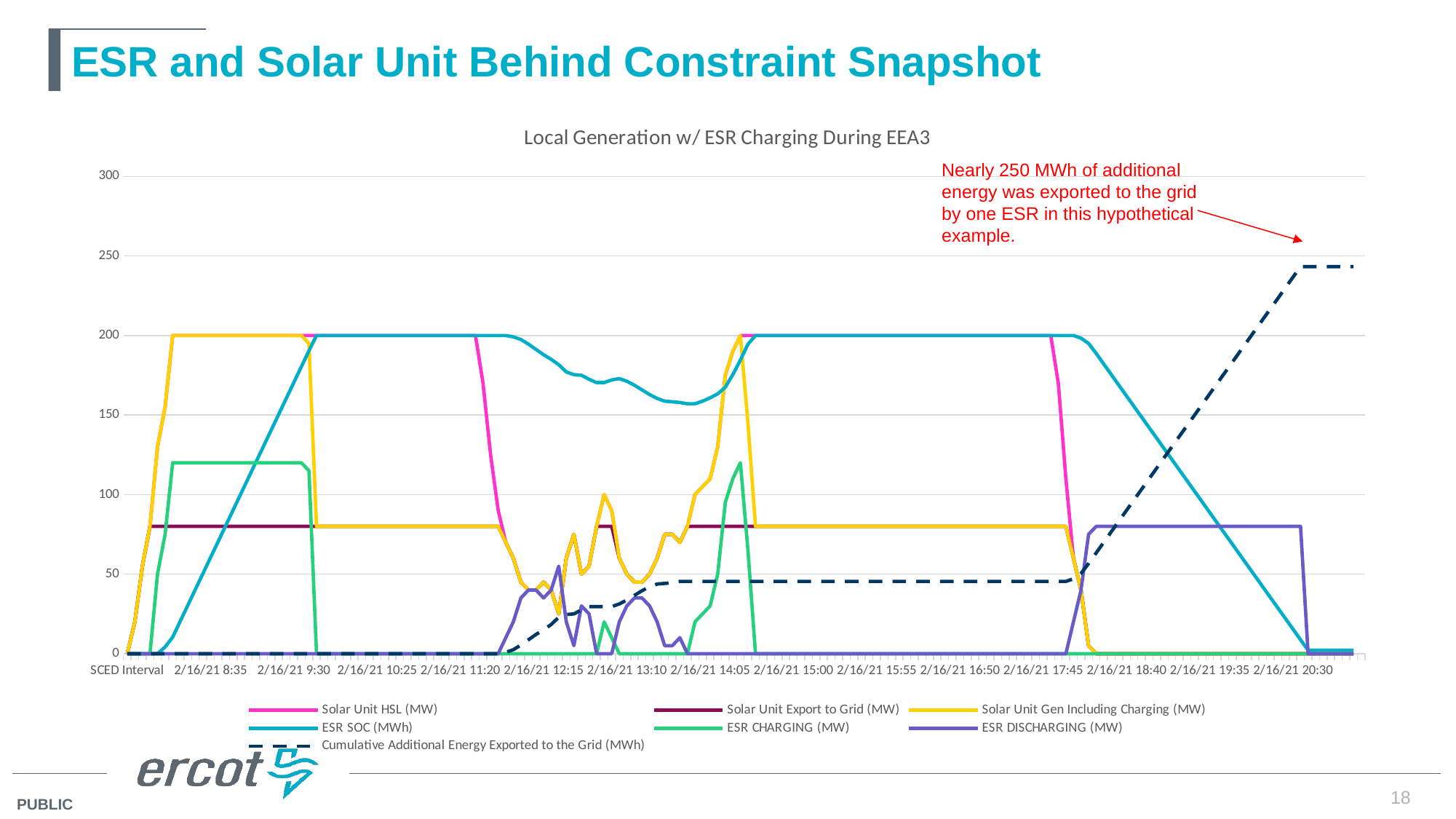
What type of chart is shown on the slide? line chart Is the value of Cumulative Additional Energy Exported to the Grid (MWh) at 2/16/21 20:30 greater or less than 200? greater Is the value of ESR CHARGING (MW) at 2/16/21 9:30 greater or less than 100? greater Is the value of Solar Unit Export to Grid (MW) at 2/16/21 10:25 greater or less than 100? less How many series does the chart legend list? 7 What is the title of the chart? Local Generation w/ ESR Charging During EEA3 At 2/16/21 18:40, which is larger: ESR SOC (MWh) or ESR DISCHARGING (MW)? ESR SOC (MWh) What is the plateau value of Solar Unit HSL (MW) during the morning, e.g. at 2/16/21 9:30? 200 What is the maximum value reached by ESR SOC (MWh)? 200 Does the Cumulative Additional Energy Exported to the Grid (MWh) series rise or fall overall from left to right? rise Which series is drawn as a dashed line? Cumulative Additional Energy Exported to the Grid (MWh)